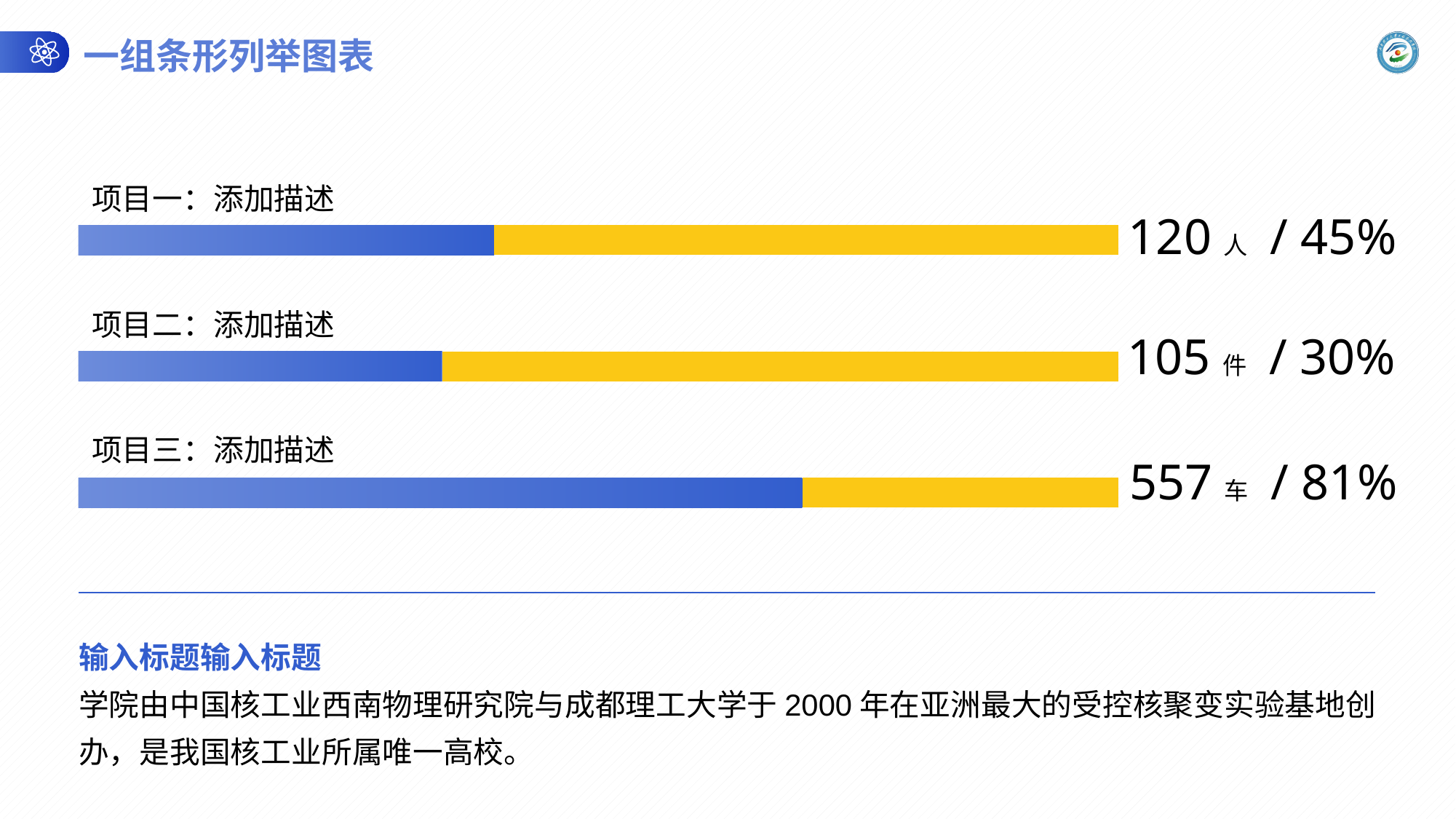
What value is shown for 项目一? 120 人 / 45% What is the difference in percentage between 项目三 and 项目一? 36% How many items (bars) are shown on the slide? 3 What kind of chart is shown on the slide? bar chart What colour is the filled (progress) portion of each bar? blue What is the title of the slide? 一组条形列举图表 What count is shown for 项目三? 557 车 What percentage is shown for 项目二? 30% Which has a larger percentage, 项目一 or 项目二? 项目一 Which item has the lowest percentage? 项目二 What is the difference in percentage between 项目一 and 项目二? 15% Which item has the highest percentage? 项目三